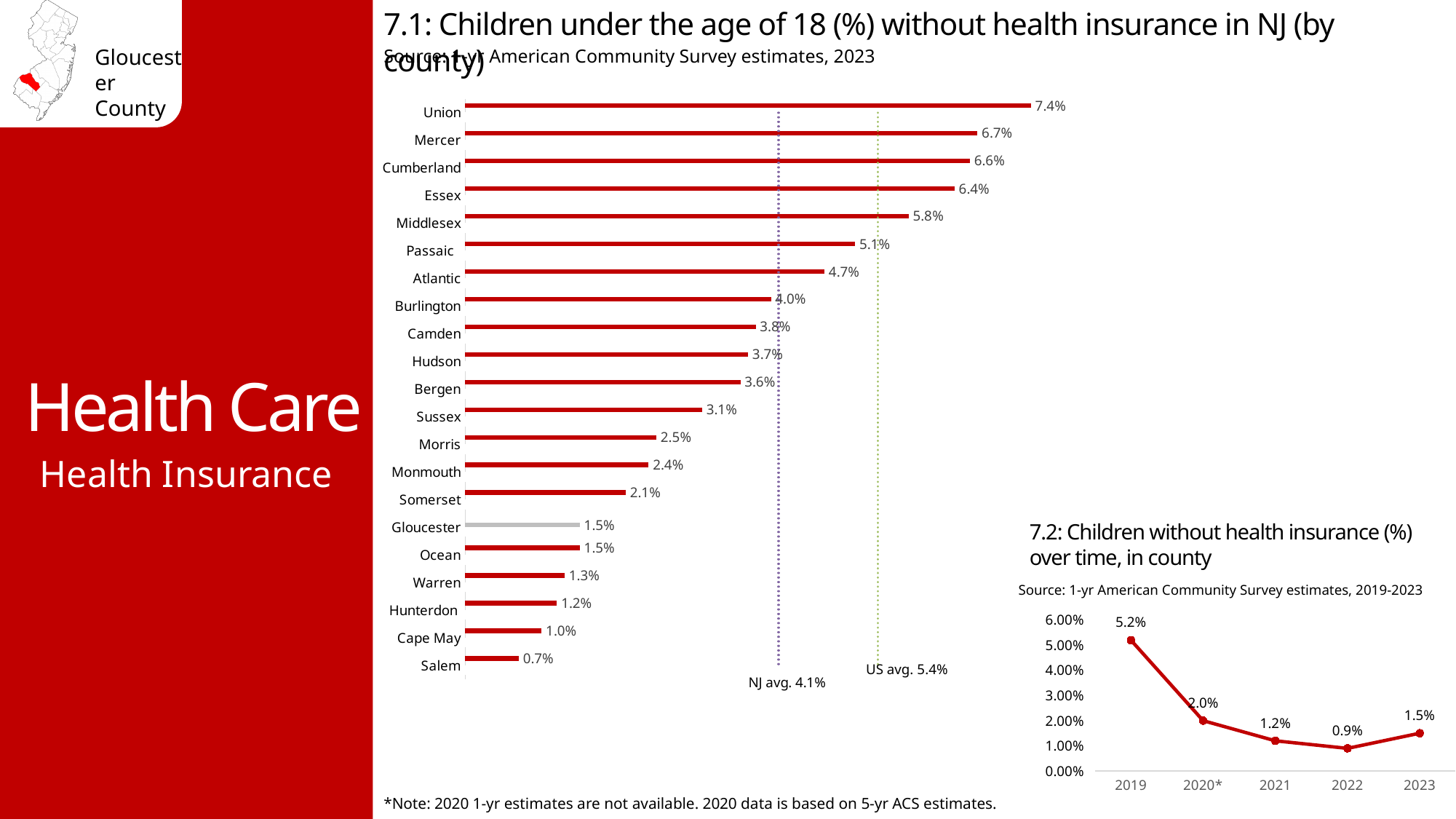
In chart 7.1, which county has a larger value, Camden or Burlington? Burlington In chart 7.2, how many data points are plotted? 5 What kind of chart is chart 7.1? bar chart In chart 7.1, what is the difference between the values for Union and Salem? 6.7% In chart 7.1, what is the NJ average shown by the dotted line? 4.1% In chart 7.2 (children without health insurance over time), what is the value for 2022? 0.9% In chart 7.1, which county has the highest percentage of children without health insurance? Union In chart 7.2, what is the difference between the 2019 and 2023 values? 3.7% In chart 7.2, which year has the highest value? 2019 In chart 7.1, how many counties are shown? 21 In chart 7.1, which county has the lowest percentage of children without health insurance? Salem In chart 7.1 (children under 18 without health insurance by county), what is the value for Gloucester? 1.5%